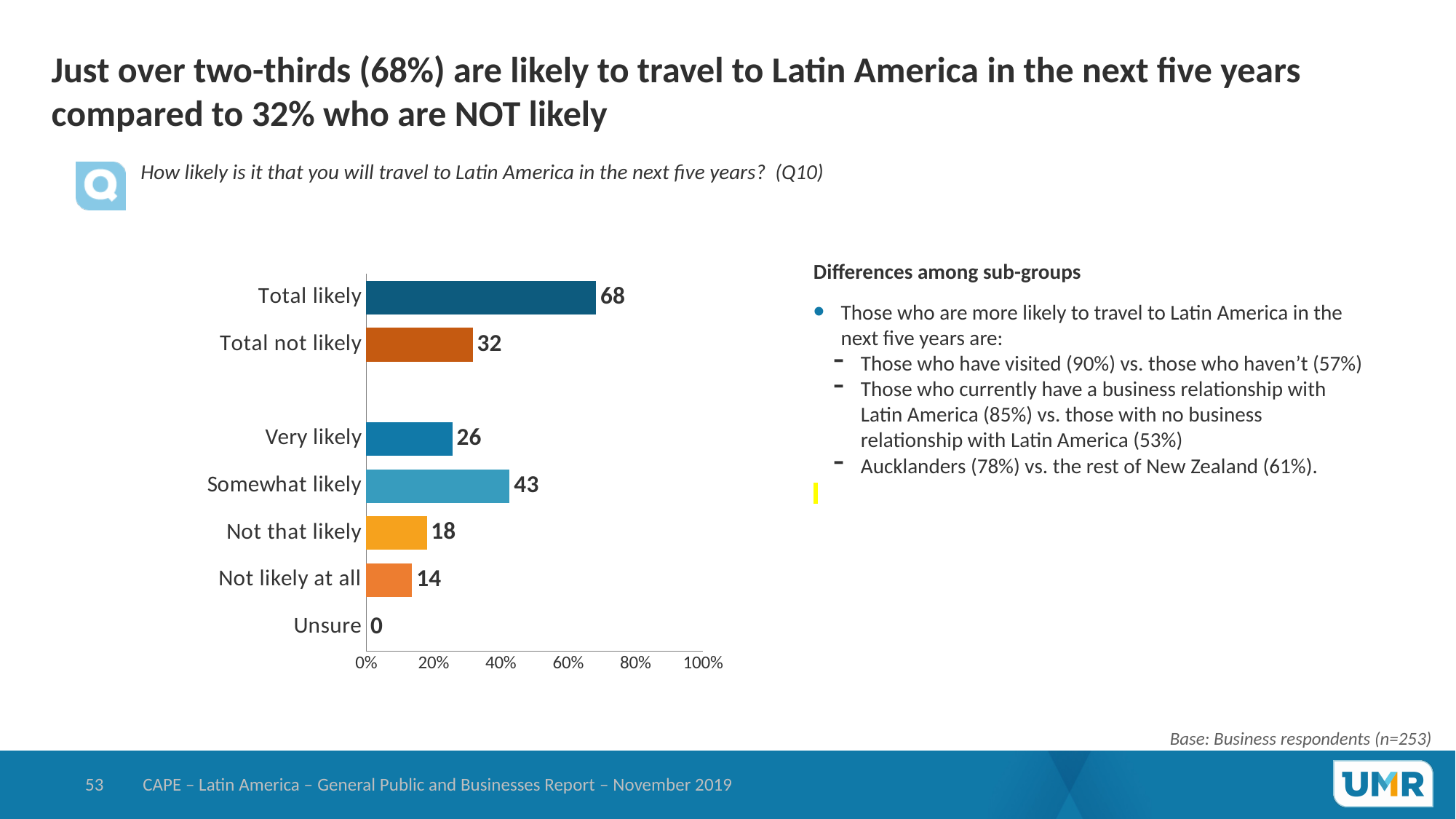
Which category has the lowest value? Unsure What is the value for Somewhat likely? 43 What is the value for Not likely at all? 14 Is the value for Very likely greater or less than 20%? greater What is the difference between Somewhat likely and Very likely? 17 What is the value for Total likely? 68 What is the difference between Total likely and Total not likely? 36 What is the value for Unsure? 0 How many categories are shown on the chart? 7 What kind of chart is shown on the slide? Bar chart Which is larger, Not that likely or Not likely at all? Not that likely Which category has the highest value? Total likely